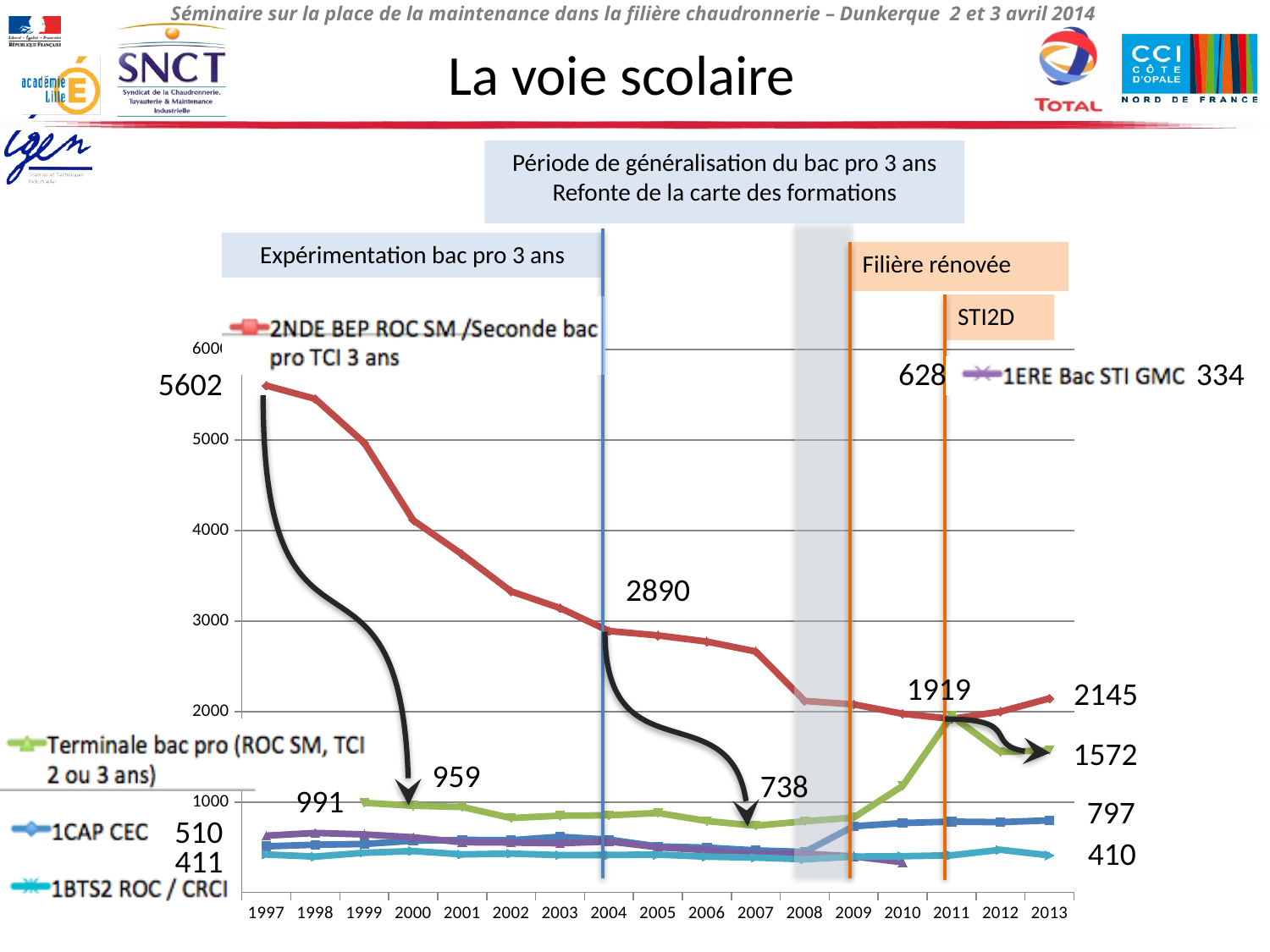
What is the value of the '2NDE BEP ROC SM /Seconde bac pro TCI 3 ans' series in 1997? 5602 What is the value of the '1CAP CEC' series in 2013? 797 Does the '2NDE BEP ROC SM /Seconde bac pro TCI 3 ans' series rise or fall from 1997 to 2013? fall How many series does the chart's legend list? 5 What kind of chart is shown on the slide? line chart In 2013, which is larger: the '2NDE BEP ROC SM /Seconde bac pro TCI 3 ans' value or the 'Terminale bac pro (ROC SM, TCI 2 ou 3 ans)' value? 2NDE BEP ROC SM /Seconde bac pro TCI 3 ans What is the value of the '2NDE BEP ROC SM /Seconde bac pro TCI 3 ans' series in 2004? 2890 What is the difference between the 1997 and 2013 values of the '2NDE BEP ROC SM /Seconde bac pro TCI 3 ans' series? 3457 How many years are shown on the x axis of the chart? 17 Is the value of the '2NDE BEP ROC SM /Seconde bac pro TCI 3 ans' series in 2008 greater or less than 3000? less